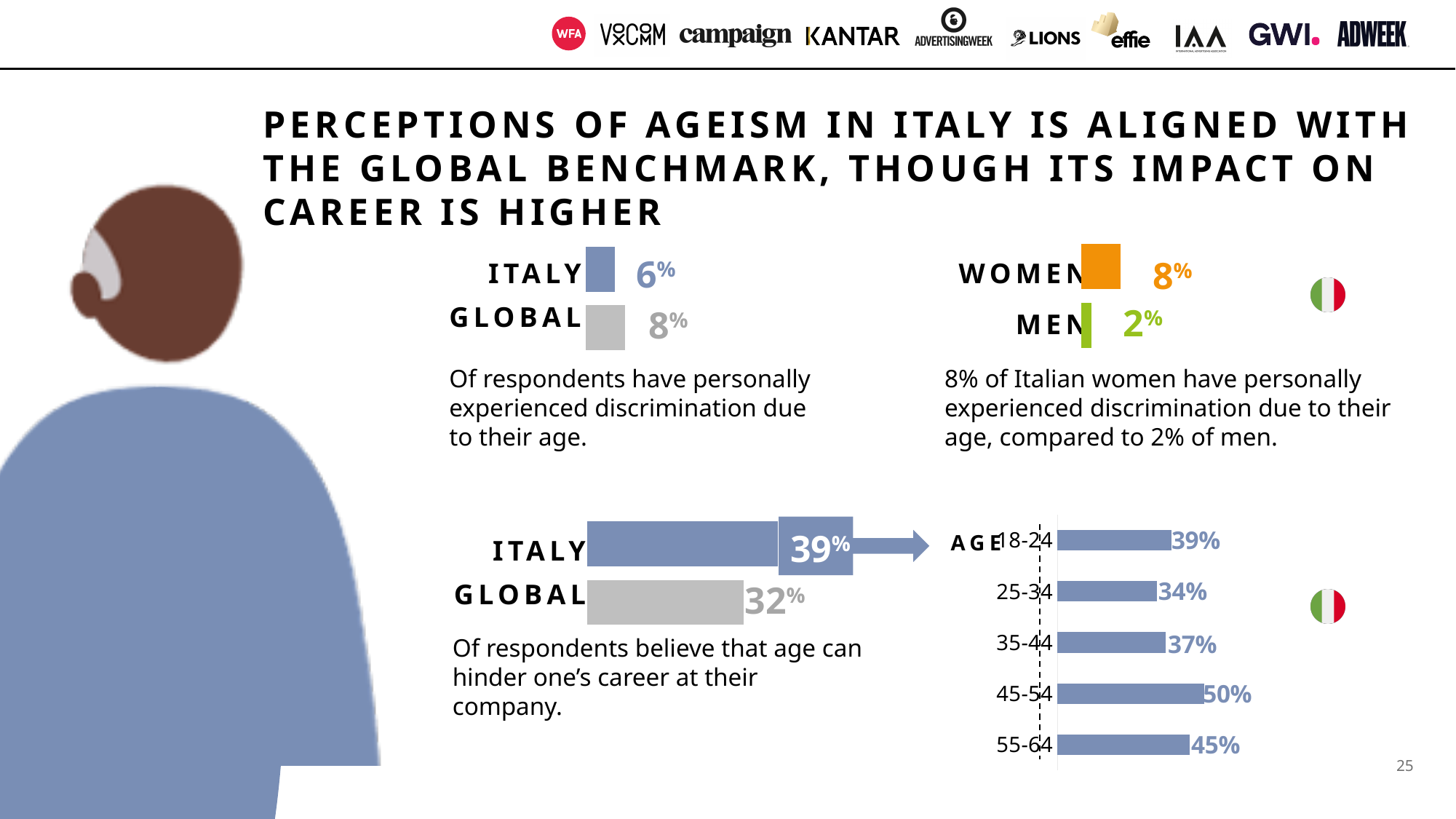
In the top-left chart comparing Italy and Global on personally experienced age discrimination, what is the value for Italy? 6% In the bottom-left chart on whether age can hinder one's career, which is larger, Italy or Global? Italy How many age groups are shown in the bottom-right chart? 5 In the bottom-left chart on whether age can hinder one's career, what is the difference between the Italy and Global values? 7% In the bottom-right chart by age group, what is the value for the 55-64 age group? 45% In the bottom-right chart by age group, which age group has the lowest value? 25-34 In the bottom-right chart by age group, which age group has the highest value? 45-54 In the bottom-left chart on whether age can hinder one's career, what is the value for Italy? 39% In the top-left chart comparing Italy and Global on personally experienced age discrimination, what is the value for Global? 8% In the top-right chart comparing women and men, what is the value for Women? 8% In the top-right chart comparing women and men, what is the difference between the Women and Men values? 6% What kind of chart is the bottom-right chart by age group? Bar chart